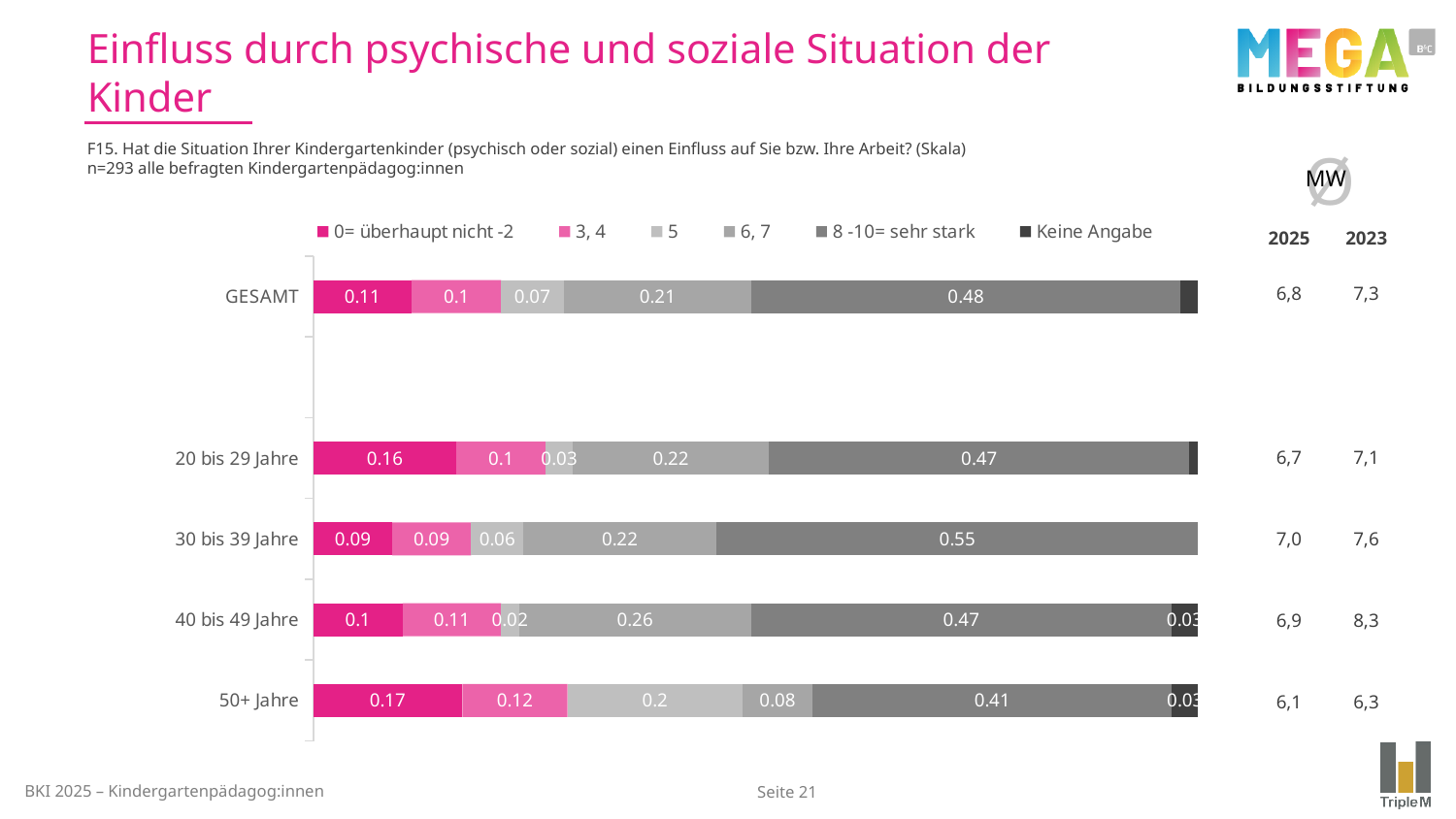
What kind of chart is shown on the slide? Stacked bar chart What is the value of the '6, 7' segment for 40 bis 49 Jahre? 0.26 What is the value of the '5' segment for 30 bis 39 Jahre? 0.06 What is the title of the slide? Einfluss durch psychische und soziale Situation der Kinder Which category has the highest value for '8 -10= sehr stark'? 30 bis 39 Jahre What is the value of the '0= überhaupt nicht -2' segment for 50+ Jahre? 0.17 What is the value of the '8 -10= sehr stark' segment for GESAMT? 0.48 How many categories are plotted on the y axis? 5 Which category has the lowest value for '8 -10= sehr stark'? 50+ Jahre Which is larger: the '0= überhaupt nicht -2' value for 20 bis 29 Jahre or for 30 bis 39 Jahre? 20 bis 29 Jahre How many series does the legend list? 6 What is the difference between the '8 -10= sehr stark' values for 30 bis 39 Jahre and 50+ Jahre? 0.14